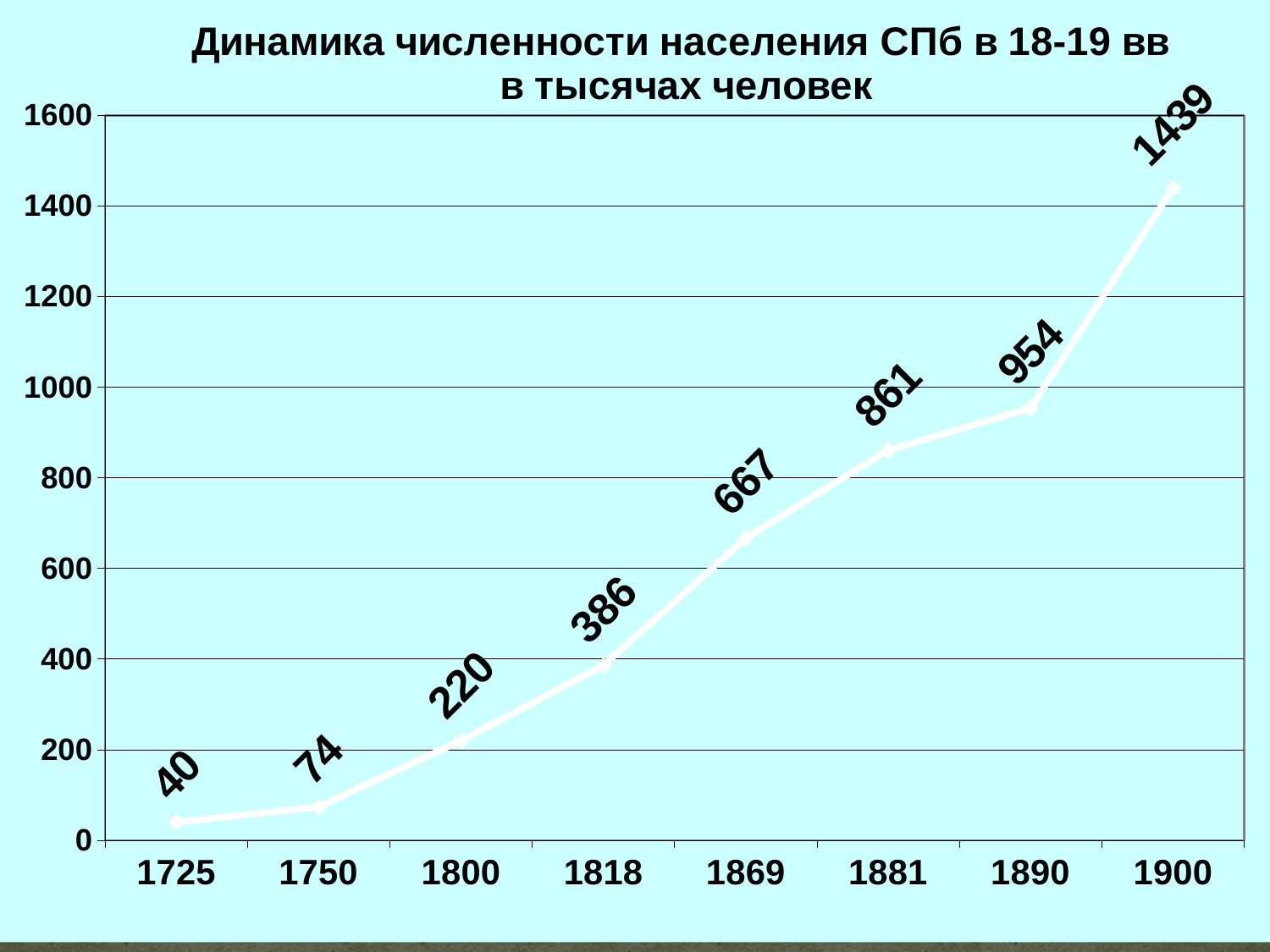
Which year has the highest population value? 1900 What is the difference between the values for 1818 and 1800? 166 Which year has the lowest population value? 1725 What is the difference between the values for 1900 and 1890? 485 What is the population value shown for 1869? 667 Do the values rise or fall from 1725 to 1900? rise How many years are plotted on the x axis? 8 What kind of chart is shown on the slide? line chart What is the population value shown for 1800? 220 Is the value for 1890 greater or less than 1000? less Which is larger, the value for 1881 or the value for 1869? 1881 What is the population value shown for 1725? 40